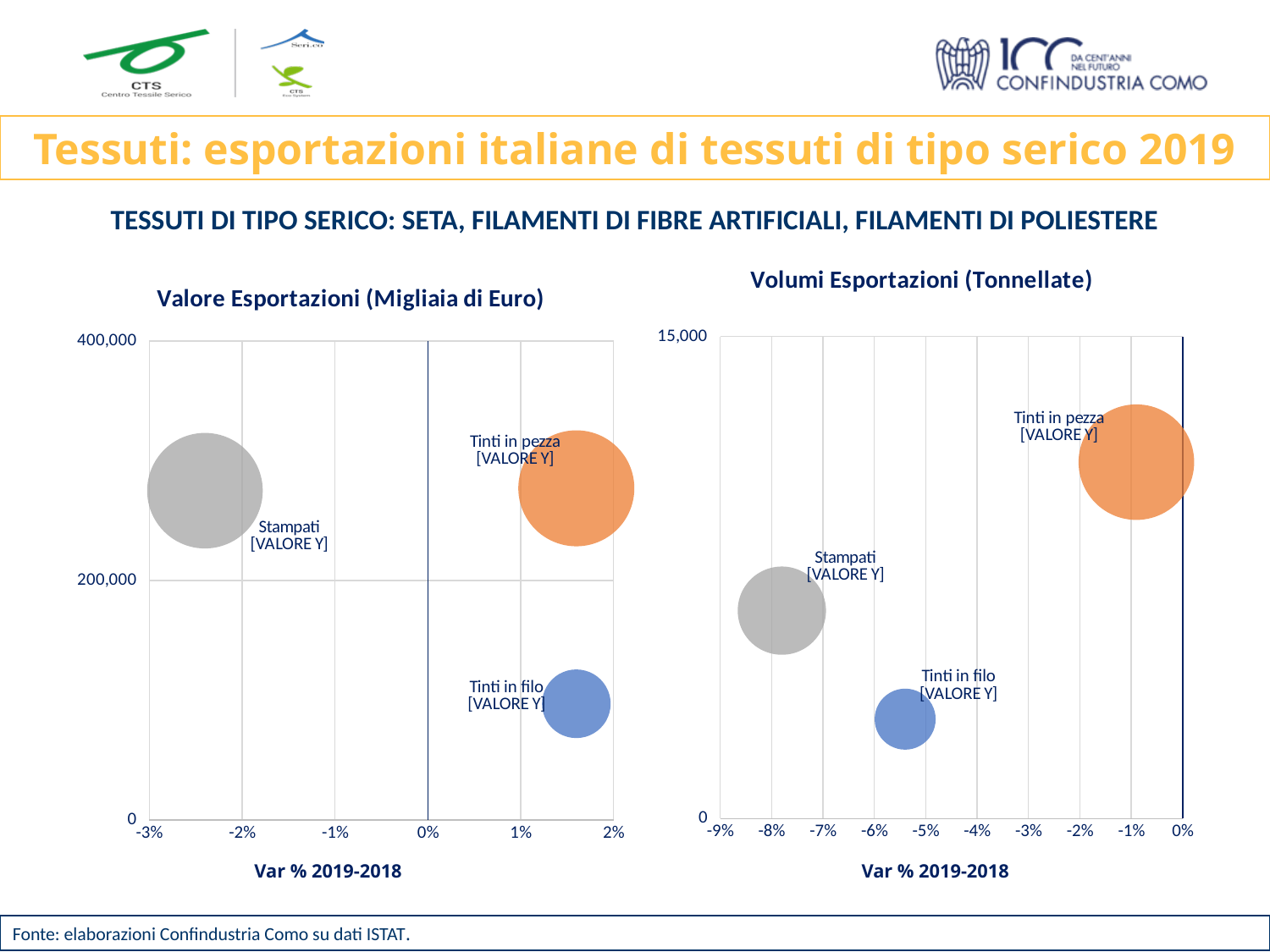
In the 'Valore Esportazioni (Migliaia di Euro)' chart, is the export value for Stampati greater or less than 200,000? greater In the 'Valore Esportazioni (Migliaia di Euro)' chart, which has the larger export value, Tinti in pezza or Tinti in filo? Tinti in pezza In the 'Volumi Esportazioni (Tonnellate)' chart, is the Var % 2019-2018 for Tinti in pezza greater or less than -2%? greater In the 'Volumi Esportazioni (Tonnellate)' chart, is the Var % 2019-2018 for Stampati greater or less than -7%? less What is the x-axis label of the 'Volumi Esportazioni (Tonnellate)' chart? Var % 2019-2018 In the 'Valore Esportazioni (Migliaia di Euro)' chart, which category has the lowest export value? Tinti in filo In the 'Volumi Esportazioni (Tonnellate)' chart, which category has the lowest export volume? Tinti in filo How many bubbles (categories) are plotted in the 'Volumi Esportazioni (Tonnellate)' chart? 3 What kind of chart is the 'Valore Esportazioni (Migliaia di Euro)' chart? bubble chart In the 'Volumi Esportazioni (Tonnellate)' chart, which category has the highest export volume? Tinti in pezza